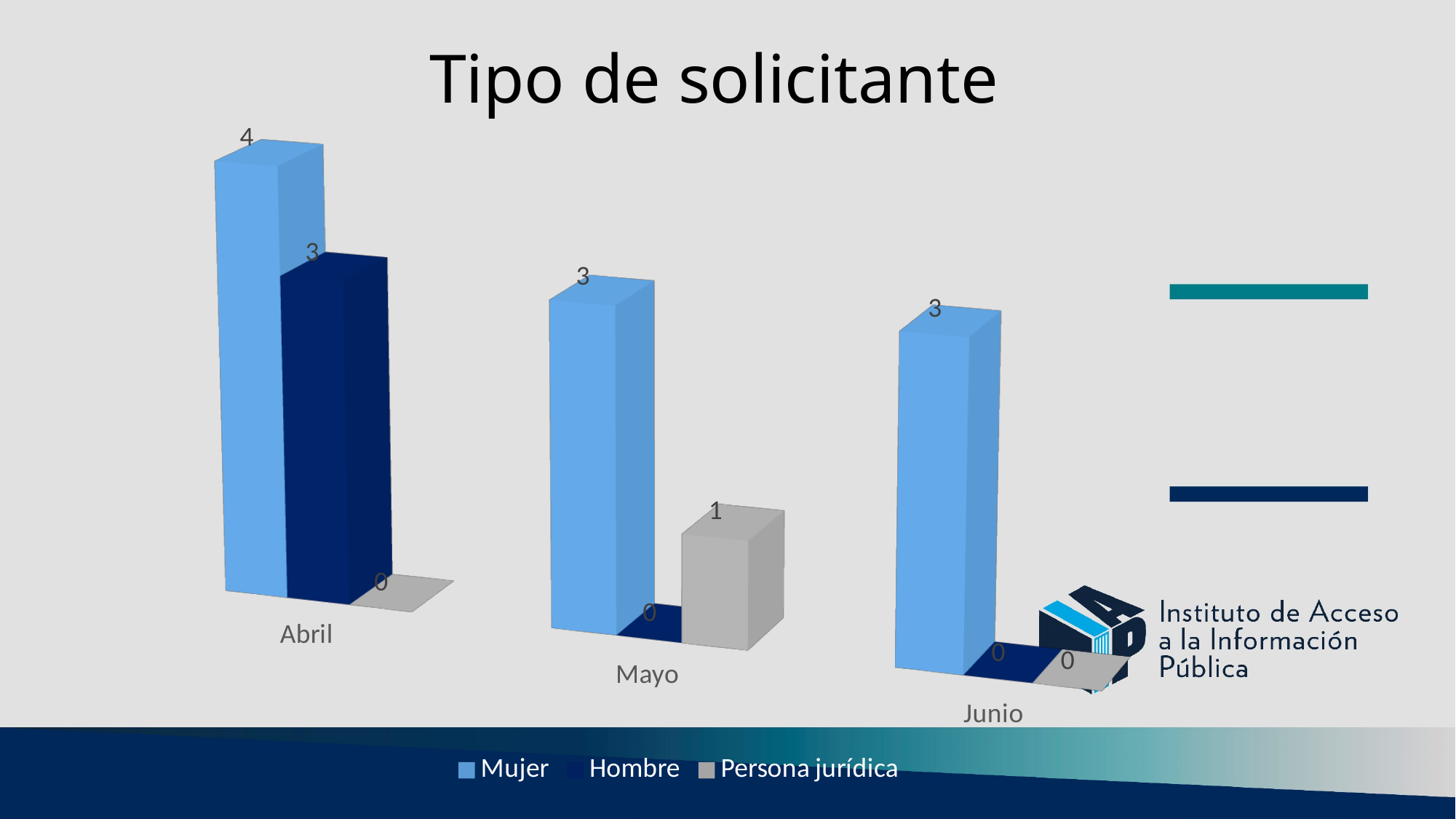
What kind of chart is shown on the slide? Bar chart What is the title of the chart? Tipo de solicitante Which month has the highest value for Mujer? Abril Which is larger in Mayo, the Mujer value or the Persona jurídica value? Mujer What is the value for Hombre in Junio? 0 What is the difference between the Mujer and Hombre values in Abril? 1 How many series does the legend list? 3 How many months are shown on the x axis? 3 What is the value for Mujer in Abril? 4 Which month has the highest value for Persona jurídica? Mayo What is the value for Hombre in Abril? 3 What is the value for Persona jurídica in Mayo? 1